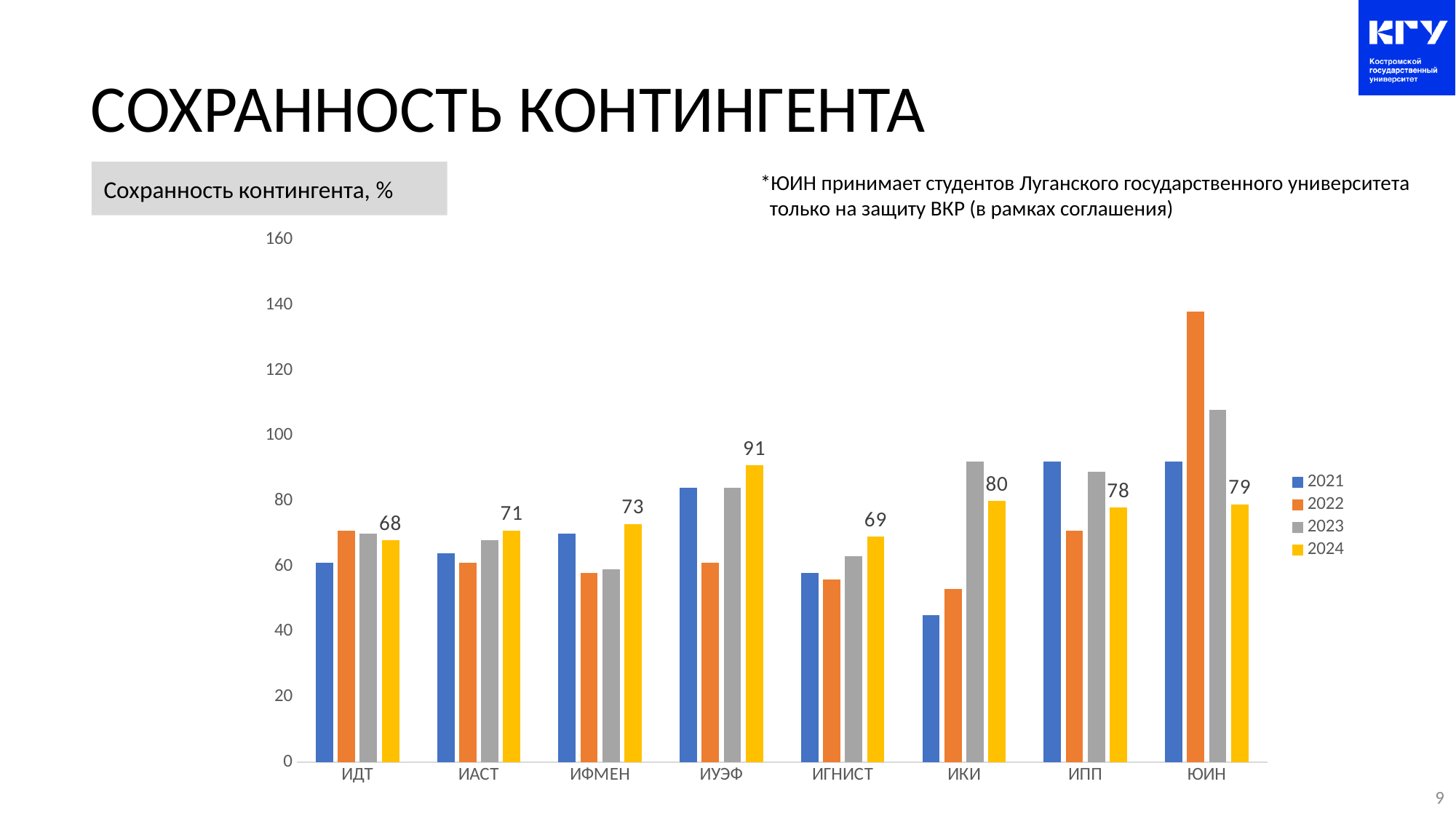
Which category has the lowest 2024 value? ИДТ What is the 2024 value for ИКИ? 80 What is the 2024 value for ИУЭФ? 91 What is the difference between the 2024 values for ИУЭФ and ИДТ? 23 Which category has the highest 2024 value? ИУЭФ Which is larger, the 2024 value for ИКИ or the 2024 value for ИПП? ИКИ How many series does the legend list? 4 What type of chart is shown on the slide? bar chart Is the 2022 value for ЮИН greater or less than 120? greater What is the 2024 value for ИДТ? 68 How many categories are shown on the x axis? 8 Is the 2021 value for ИКИ greater or less than 60? less